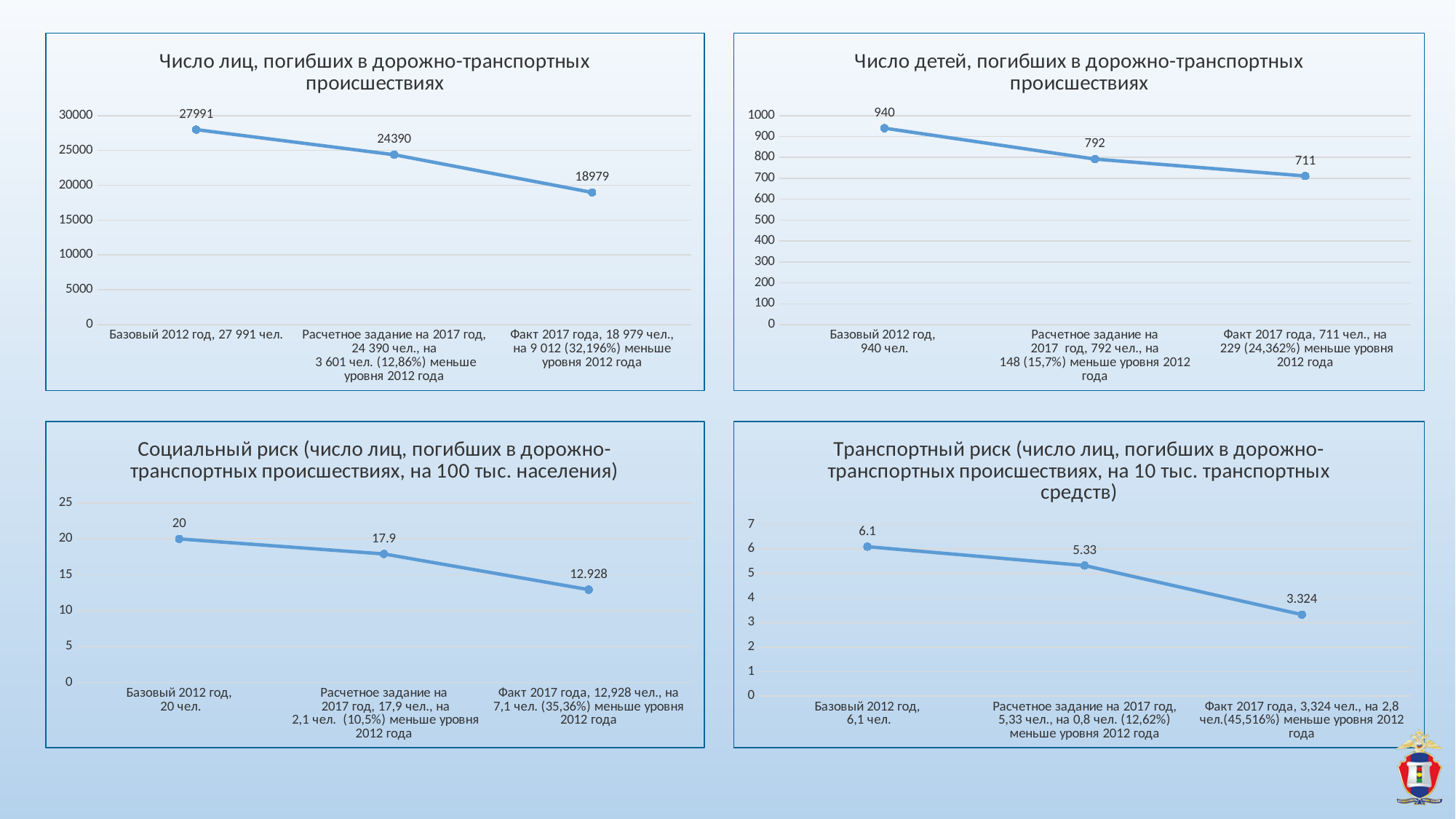
In the bottom-left chart (Социальный риск), is the value for Расчетное задание на 2017 год greater or less than 15? greater In the top-right chart (Число детей, погибших в дорожно-транспортных происшествиях), what is the value for Расчетное задание на 2017 год? 792 In the bottom-right chart (Транспортный риск), which is larger: the value for Базовый 2012 год or the value for Факт 2017 года? Базовый 2012 год In the top-right chart (Число детей, погибших в дорожно-транспортных происшествиях), what is the difference between the Базовый 2012 год value and the Факт 2017 года value? 229 In the top-left chart (Число лиц, погибших в дорожно-транспортных происшествиях), what is the value for Факт 2017 года? 18979 In the top-right chart (Число детей, погибших в дорожно-транспортных происшествиях), which point has the lowest value? Факт 2017 года In the bottom-right chart (Транспортный риск), do the values rise or fall from left to right? fall In the bottom-right chart (Транспортный риск), what is the value for Расчетное задание на 2017 год? 5.33 In the top-left chart (Число лиц, погибших в дорожно-транспортных происшествиях), what is the value for Базовый 2012 год? 27991 What type of chart is the top-left chart (Число лиц, погибших в дорожно-транспортных происшествиях)? line chart In the top-left chart (Число лиц, погибших в дорожно-транспортных происшествиях), what is the difference between the Базовый 2012 год value and the Расчетное задание на 2017 год value? 3601 In the bottom-left chart (Социальный риск), what is the value for Факт 2017 года? 12.928